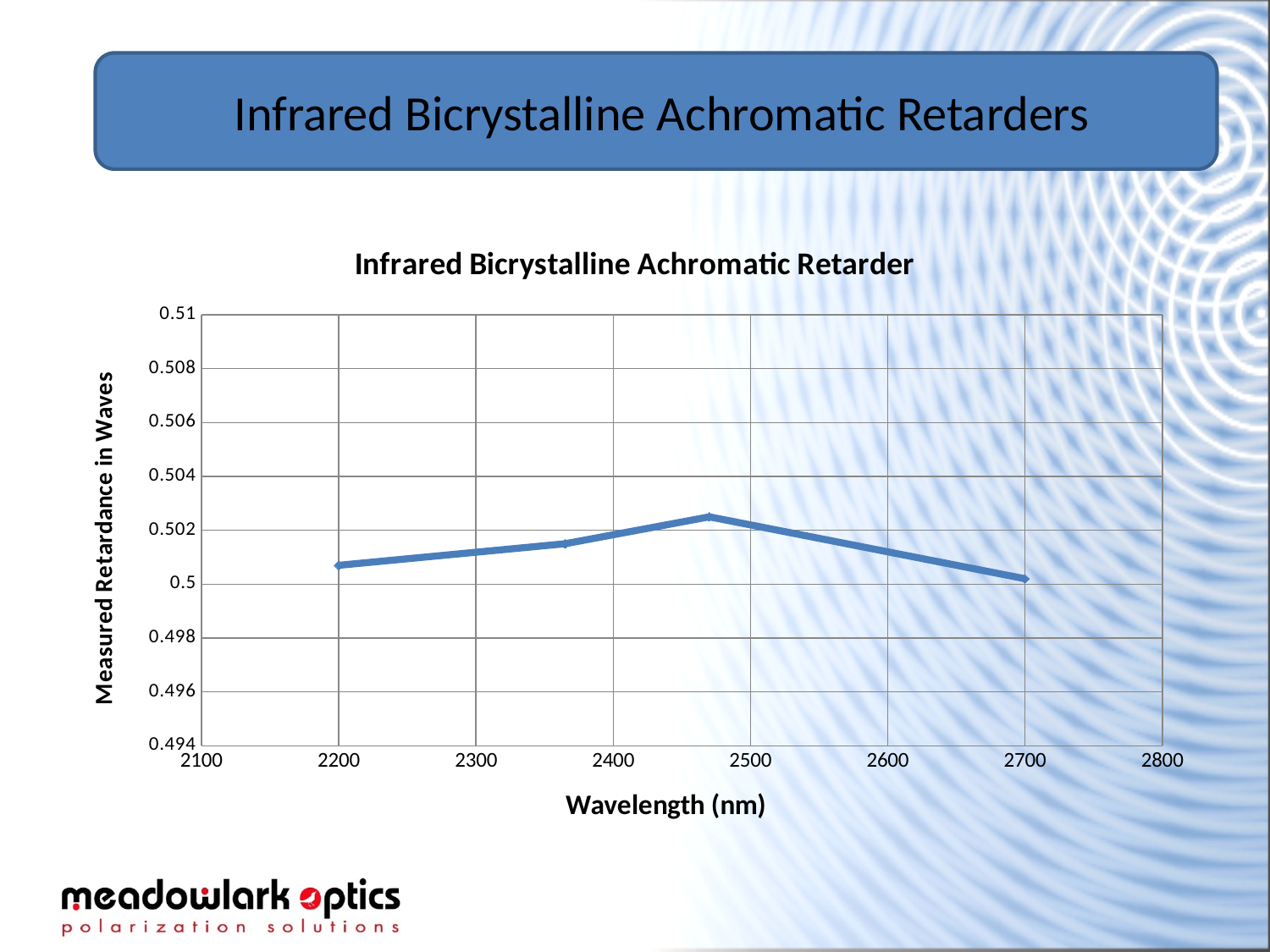
What is the label of the y axis? Measured Retardance in Waves What is the title of the chart? Infrared Bicrystalline Achromatic Retarder What kind of chart is shown on the slide? line chart Does the line rise or fall between 2200 nm and 2400 nm? rise Is the highest point on the line greater or less than 0.504? less Is the measured retardance at 2200 nm greater or less than 0.5? greater How many data points are plotted on the line? 4 Does the line rise or fall between 2500 nm and 2700 nm? fall Is the measured retardance at 2700 nm greater or less than 0.502? less Which has the higher measured retardance, the point at 2200 nm or the point at 2700 nm? 2200 nm Does the peak of the line occur between 2400 nm and 2500 nm? yes